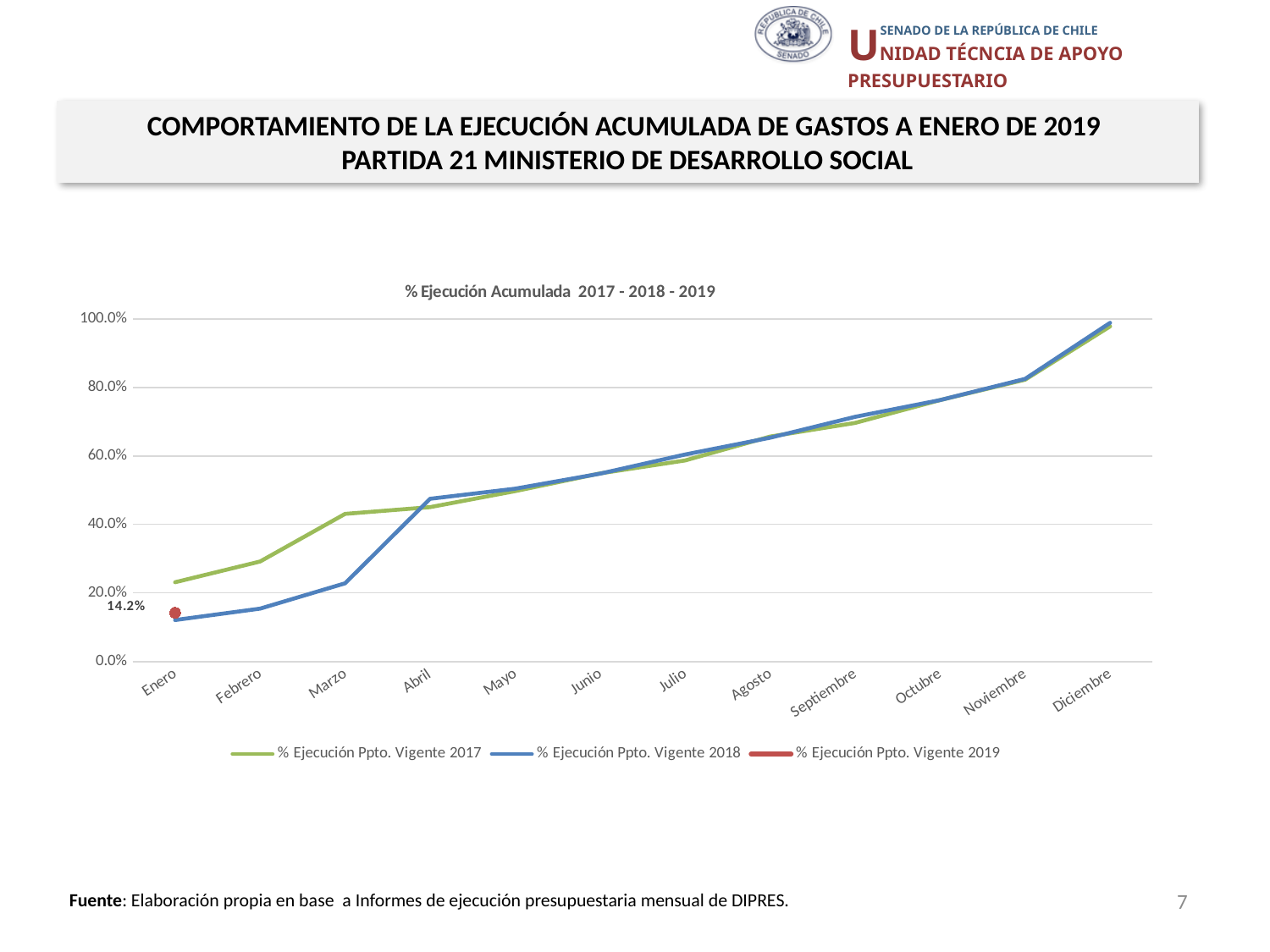
In Febrero, which series has the larger value, % Ejecución Ppto. Vigente 2017 or % Ejecución Ppto. Vigente 2018? % Ejecución Ppto. Vigente 2017 In Marzo, which series has the larger value, % Ejecución Ppto. Vigente 2017 or % Ejecución Ppto. Vigente 2018? % Ejecución Ppto. Vigente 2017 What is the title of the chart? % Ejecución Acumulada 2017 - 2018 - 2019 What is the value for % Ejecución Ppto. Vigente 2019 in Enero? 14.2% Does the % Ejecución Ppto. Vigente 2018 line rise or fall from Enero to Diciembre? rise Is the value for % Ejecución Ppto. Vigente 2018 in Enero greater or less than 20%? less What kind of chart is shown on the slide? line chart Is the value for % Ejecución Ppto. Vigente 2018 in Marzo greater or less than 40%? less How many series does the legend list? 3 How many months are shown on the x axis? 12 Is the value for % Ejecución Ppto. Vigente 2017 in Noviembre greater or less than 60%? greater